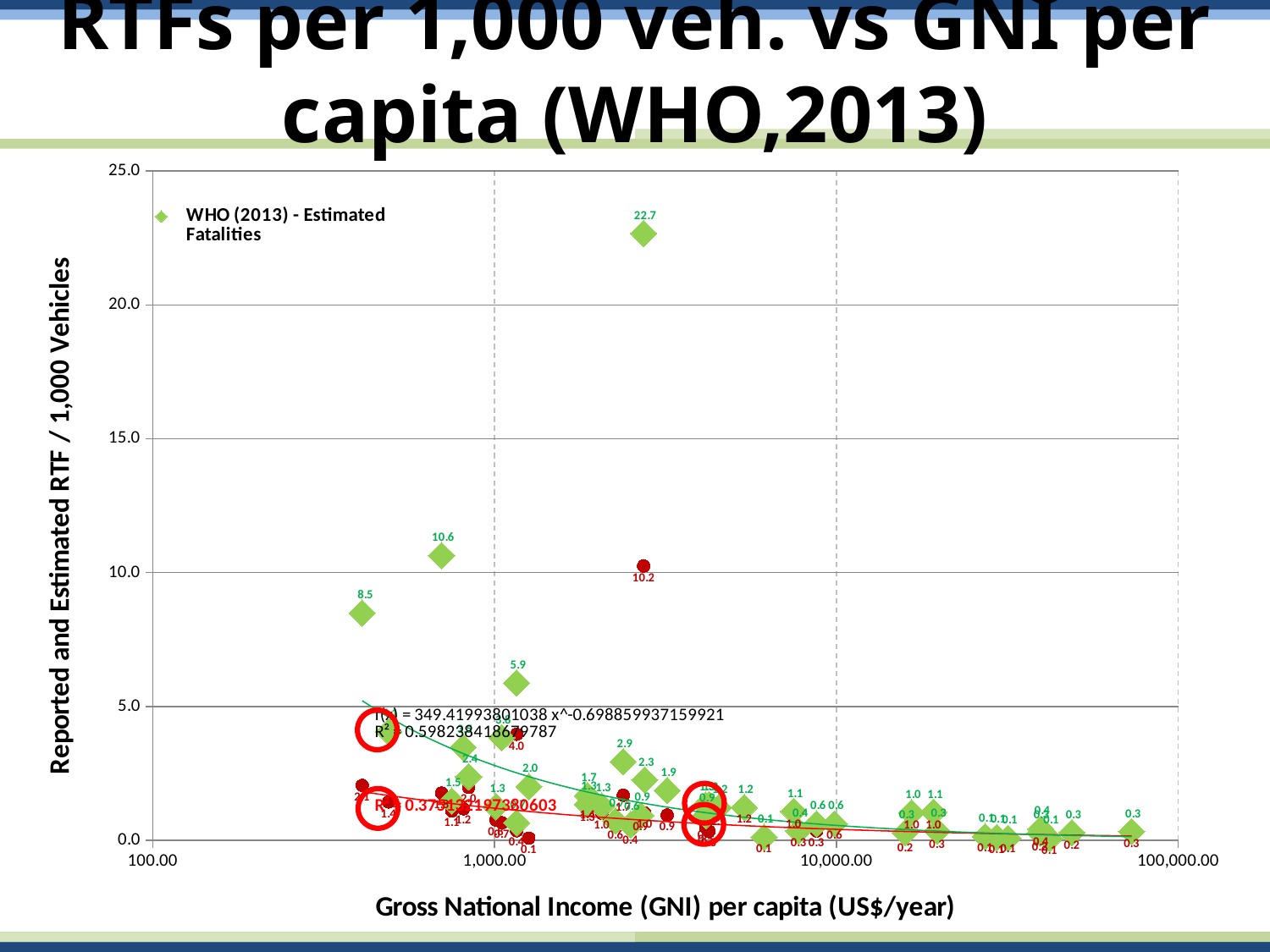
Which is larger: the highest green diamond value (22.7) or the highest red circle value (10.2)? 22.7 What is the highest labelled value among the green diamond (WHO 2013 Estimated Fatalities) points? 22.7 Is the highest green diamond point greater or less than 20.0 on the y axis? greater What series name is listed in the chart legend? WHO (2013) - Estimated Fatalities What is the highest labelled value among the red circle points? 10.2 What kind of chart is shown on the slide? scatter chart What is the maximum tick value shown on the y axis? 25.0 What is the difference between the two highest labelled green diamond values, 22.7 and 10.6? 12.1 Do the RTF values generally rise or fall as GNI per capita increases along the x axis? fall What is the difference between the green diamond values labelled 10.6 and 8.5? 2.1 Is the highest red circle point greater or less than 15.0 on the y axis? less